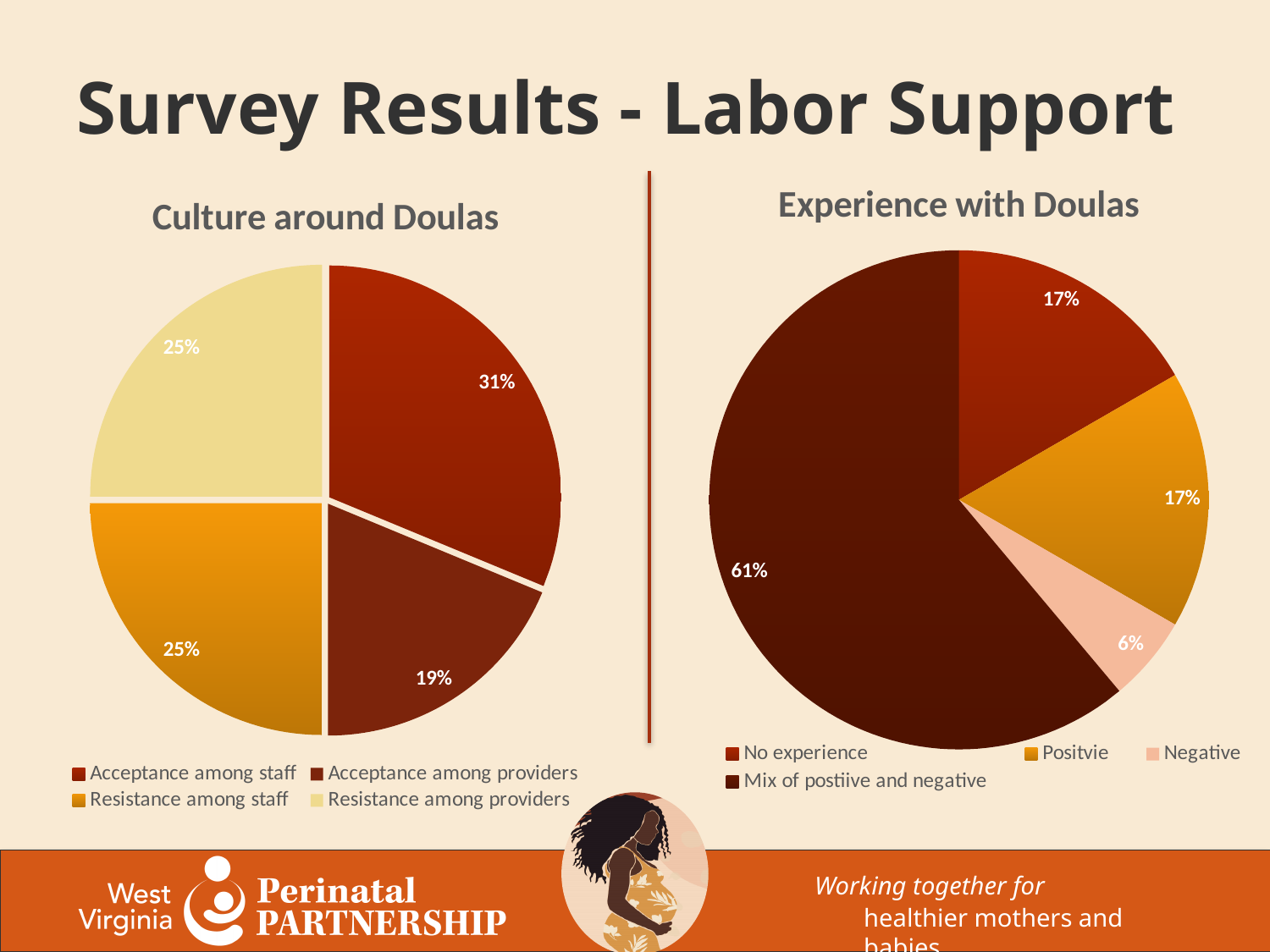
In the Culture around Doulas chart, what percentage is shown for Acceptance among providers? 19% In the Culture around Doulas chart, which category has the smallest slice? Acceptance among providers In the Experience with Doulas chart, which category has the largest slice? Mix of positive and negative In the Experience with Doulas chart, which is larger, the No experience slice or the Negative slice? No experience How many entries does the legend of the Experience with Doulas chart list? 4 In the Experience with Doulas chart, what percentage is shown for Mix of positive and negative? 61% In the Experience with Doulas chart, what percentage is shown for Negative? 6% In the Culture around Doulas chart, what percentage is shown for Acceptance among staff? 31% In the Culture around Doulas chart, which category has the largest slice? Acceptance among staff In the Culture around Doulas chart, how many slices does the pie have? 4 In the Culture around Doulas chart, what is the difference between the Acceptance among staff slice and the Acceptance among providers slice? 12% What type of chart is the Experience with Doulas chart? Pie chart